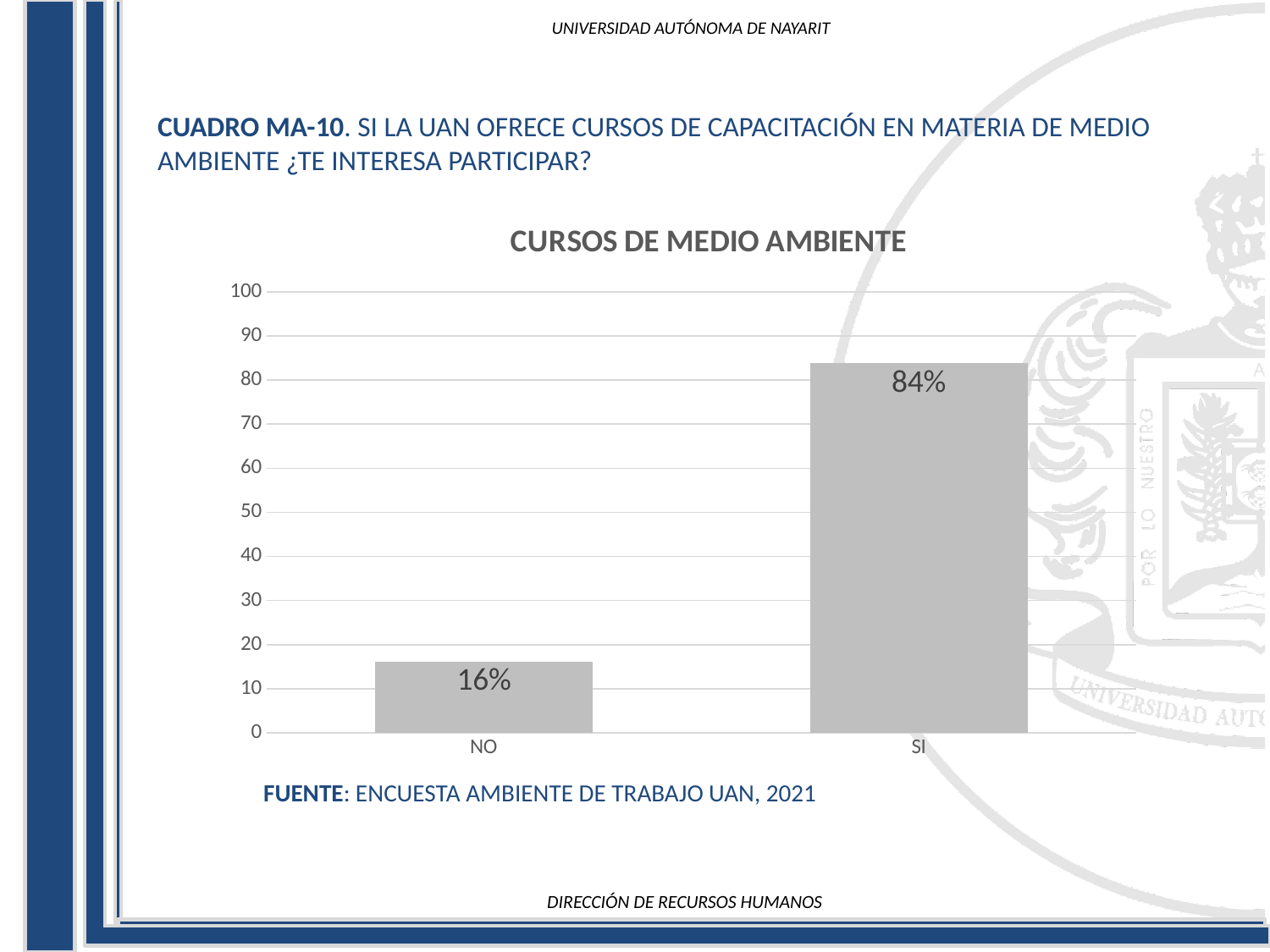
Which is larger, the value for NO or the value for SI? SI Which category has the highest value? SI Is the value for NO greater or less than 20? less How many categories are shown on the x axis? 2 What is the value for NO? 16% Is the value for SI greater or less than 80? greater What is the title of the chart? CURSOS DE MEDIO AMBIENTE What is the difference between the values for SI and NO? 68% What kind of chart is shown? bar chart Which category has the lowest value? NO What is the highest value shown on the y axis? 100 What is the value for SI? 84%